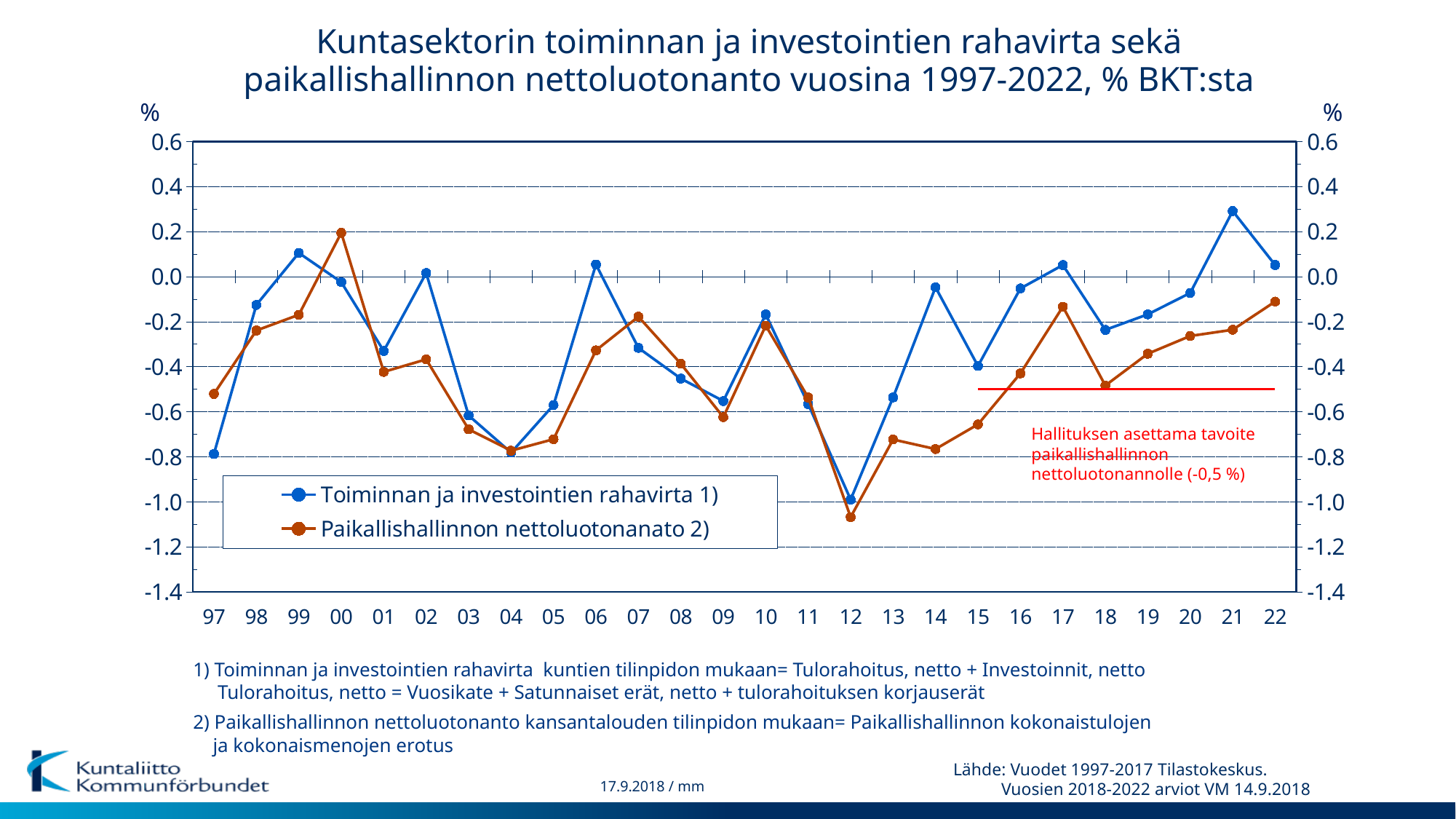
Is the value for 'Toiminnan ja investointien rahavirta 1)' in 21 greater or less than 0.2? greater In 97, which series has the larger value: 'Toiminnan ja investointien rahavirta 1)' or 'Paikallishallinnon nettoluotonanato 2)'? Paikallishallinnon nettoluotonanato 2) In which year does the series 'Paikallishallinnon nettoluotonanato 2)' reach its lowest value? 12 In which year does the series 'Paikallishallinnon nettoluotonanato 2)' reach its highest value? 00 Does the series 'Paikallishallinnon nettoluotonanato 2)' rise or fall from 18 to 22? rise In which year does the series 'Toiminnan ja investointien rahavirta 1)' reach its lowest value? 12 Is the value for 'Toiminnan ja investointien rahavirta 1)' in 97 greater or less than -0.6? less How many series does the legend list? 2 What kind of chart is shown on the slide? line chart How many years are plotted along the x axis? 26 In which year does the series 'Toiminnan ja investointien rahavirta 1)' reach its highest value? 21 Is the value for 'Paikallishallinnon nettoluotonanato 2)' in 12 greater or less than -1.0? less